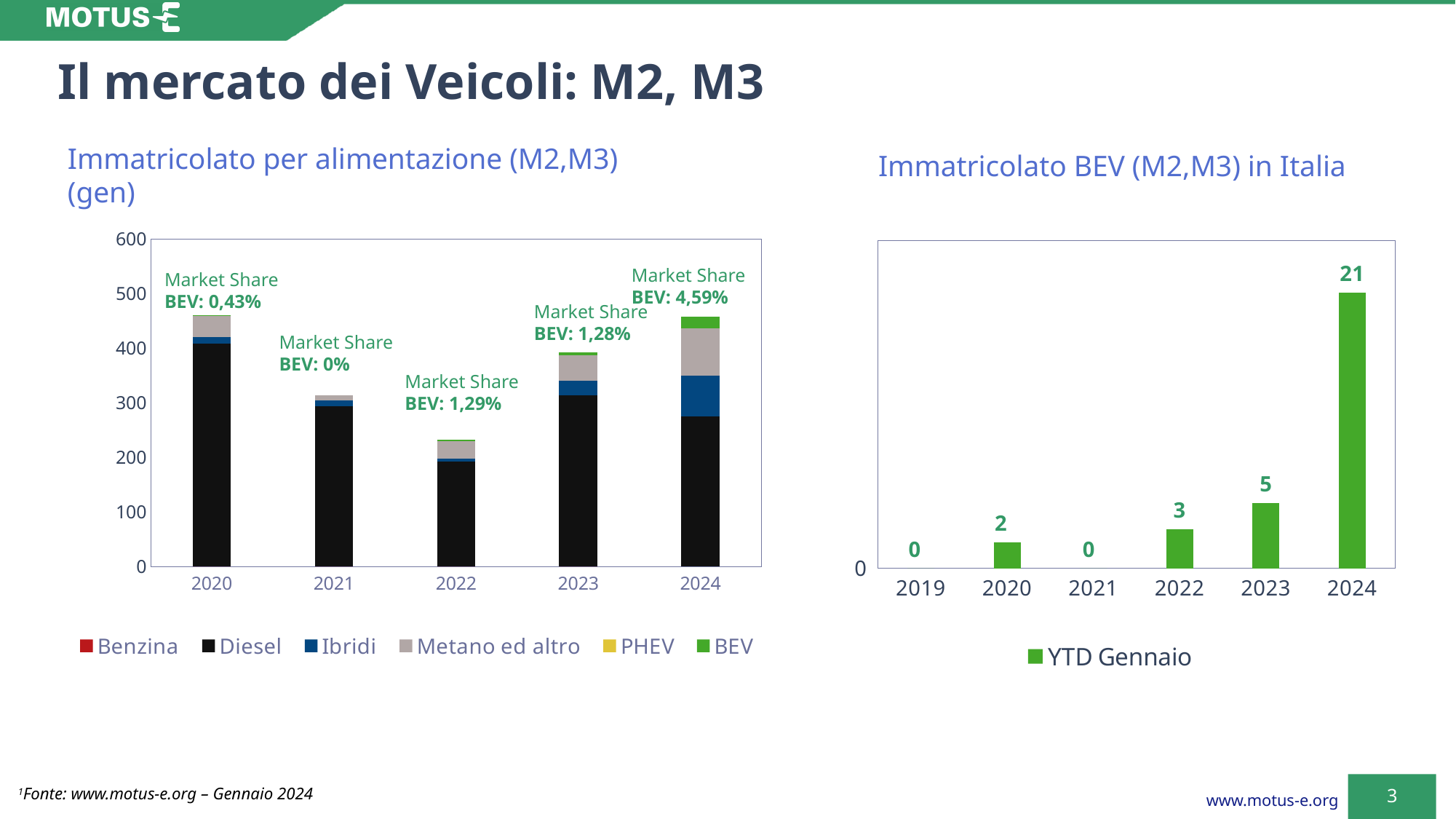
In the chart 'Immatricolato BEV (M2,M3) in Italia', what is the value for 2024? 21 In the chart 'Immatricolato BEV (M2,M3) in Italia', what is the name of the series in the legend? YTD Gennaio In the chart 'Immatricolato per alimentazione (M2,M3) (gen)', is the total height of the 2022 bar greater or less than 300? less What kind of chart is 'Immatricolato per alimentazione (M2,M3) (gen)'? stacked bar chart In the chart 'Immatricolato BEV (M2,M3) in Italia', what is the value for 2023? 5 In the chart 'Immatricolato per alimentazione (M2,M3) (gen)', what is the BEV market share shown for 2024? 4,59% In the chart 'Immatricolato per alimentazione (M2,M3) (gen)', what is the BEV market share shown for 2021? 0% In the chart 'Immatricolato BEV (M2,M3) in Italia', which is larger, the value for 2020 or the value for 2022? 2022 In the chart 'Immatricolato BEV (M2,M3) in Italia', what is the difference between the values for 2024 and 2023? 16 In the chart 'Immatricolato BEV (M2,M3) in Italia', how many years are shown on the x axis? 6 In the chart 'Immatricolato per alimentazione (M2,M3) (gen)', how many series does the legend list? 6 In the chart 'Immatricolato BEV (M2,M3) in Italia', which year has the highest value? 2024